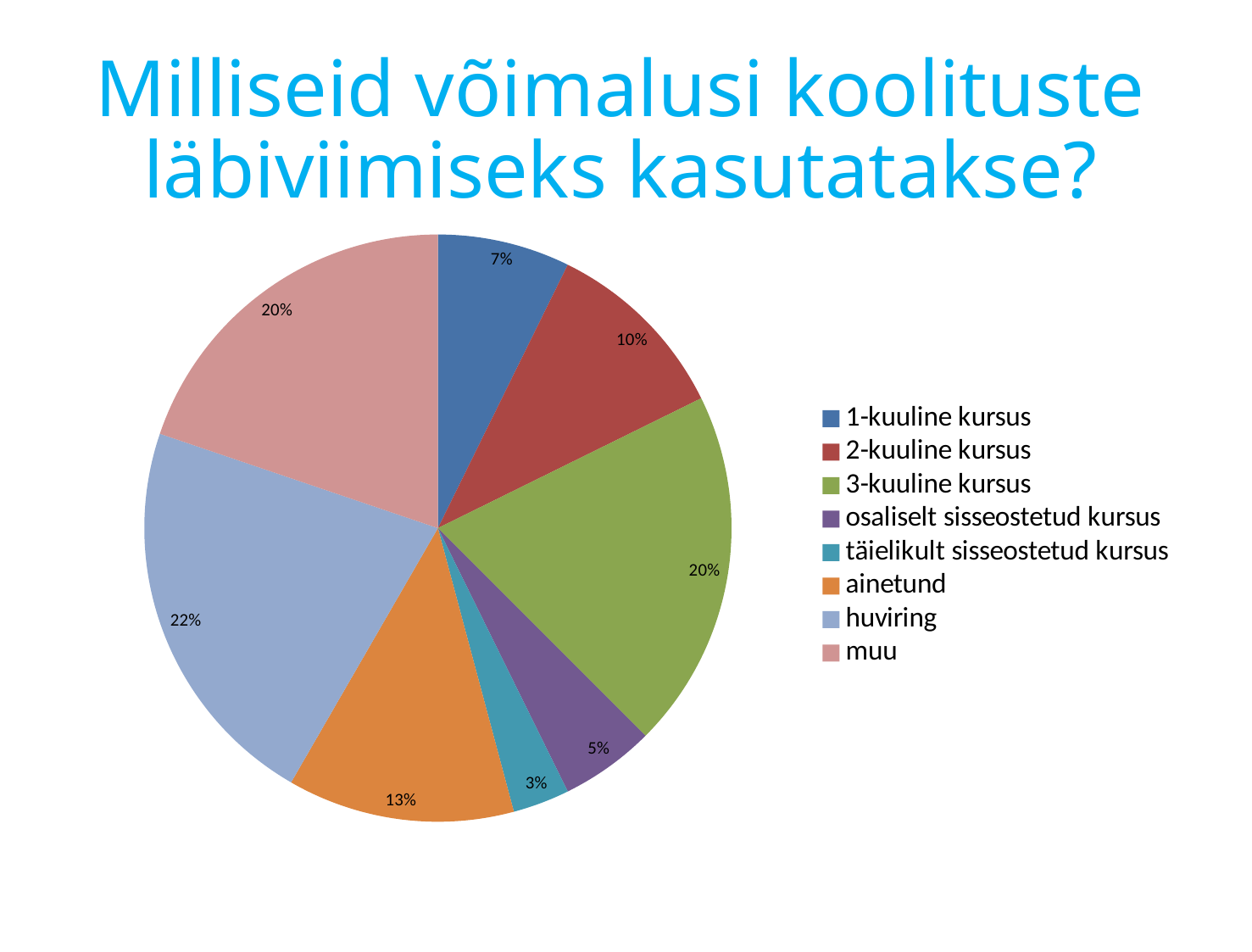
What share of the pie does huviring have? 22% What share of the pie does täielikult sisseostetud kursus have? 3% Which category has the smallest slice of the pie? täielikult sisseostetud kursus What share of the pie does 1-kuuline kursus have? 7% Which category has the largest slice of the pie? huviring How many categories does the pie chart have? 8 What colour is the slice for ainetund? orange What kind of chart is shown on the slide? pie chart Which is larger, the share of 2-kuuline kursus or the share of osaliselt sisseostetud kursus? 2-kuuline kursus What is the difference between the shares of huviring and ainetund? 9% What is the combined share of 3-kuuline kursus and muu? 40%